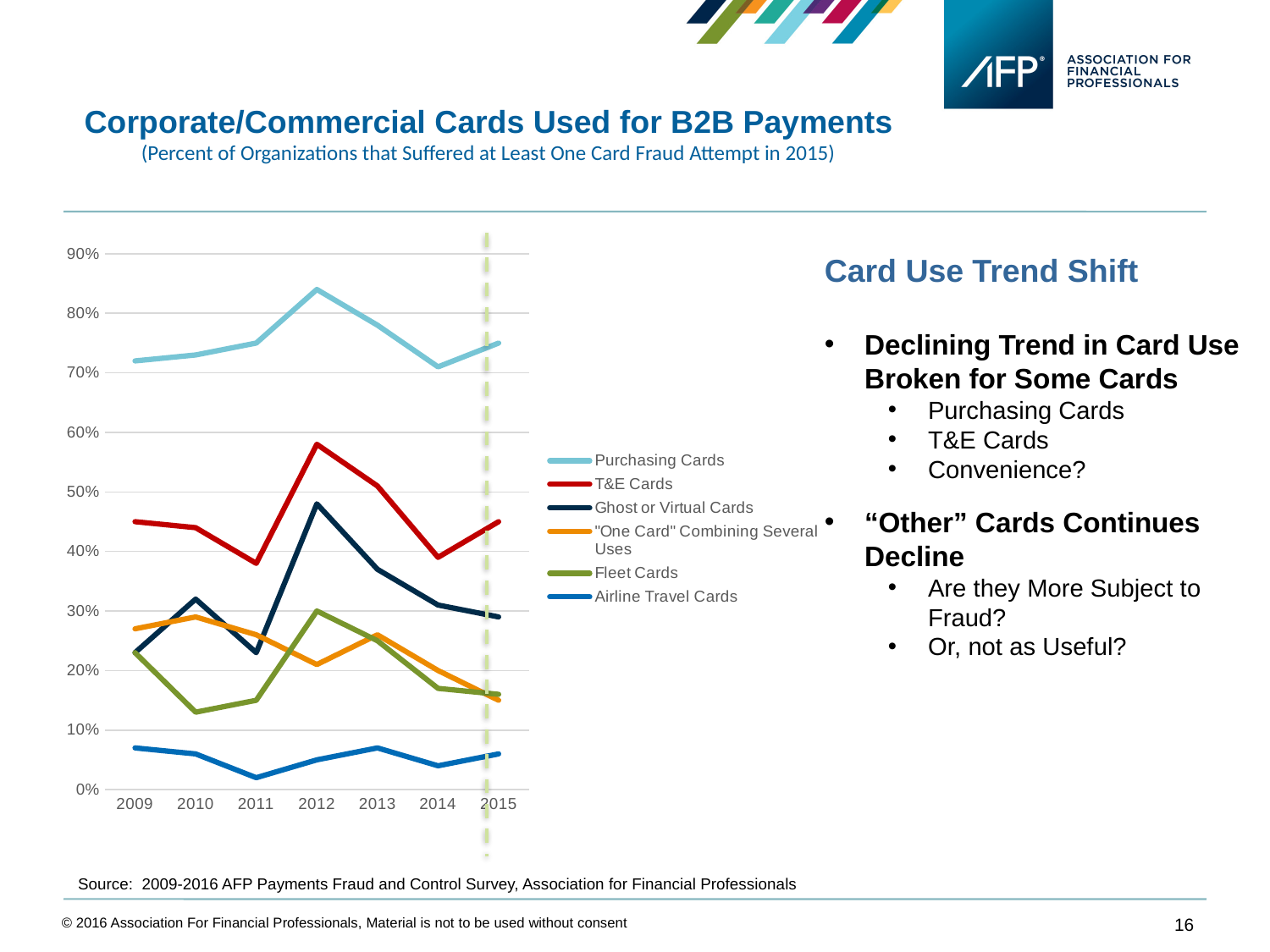
Which series has the highest value in 2012? Purchasing Cards Does the Airline Travel Cards line rise or fall from 2009 to 2011? fall Is the value for Fleet Cards in 2010 greater or less than 20%? less In which year does the Purchasing Cards line reach its peak? 2012 How many series does the legend list? 6 In 2015, which is larger: T&E Cards or Ghost or Virtual Cards? T&E Cards How many years are shown on the x axis? 7 Which series has the lowest values across all years? Airline Travel Cards Is the value for T&E Cards in 2012 greater or less than 50%? greater Is the value for Ghost or Virtual Cards in 2012 greater or less than 40%? greater What kind of chart is shown on the slide? line chart